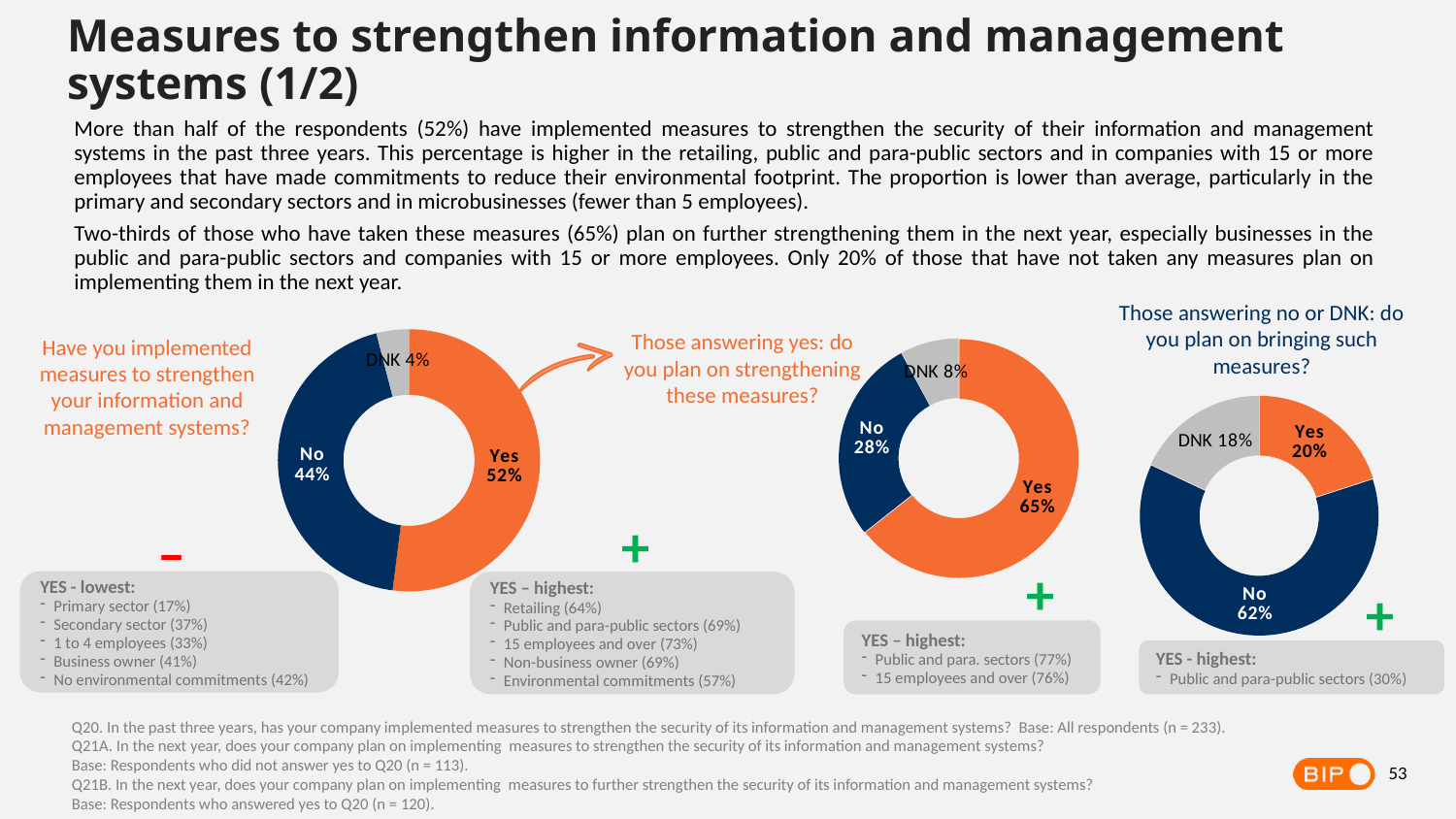
In the left chart ('Have you implemented measures to strengthen your information and management systems?'), what percentage answered Yes? 52% In the right chart ('Those answering no or DNK...'), which is larger, Yes or DNK? Yes In the left chart ('Have you implemented measures...'), which response has the smallest share? DNK In the right chart ('Those answering no or DNK...'), what percentage answered DNK? 18% In the left chart ('Have you implemented measures...'), what percentage answered No? 44% In the middle chart ('Those answering yes...'), which response has the largest share? Yes In the left chart ('Have you implemented measures...'), what is the difference in percentage points between Yes and No? 8 What kind of chart is used for the three charts on the slide? Donut (pie) chart In the middle chart ('Those answering yes: do you plan on strengthening these measures?'), what percentage answered Yes? 65% In the right chart ('Those answering no or DNK: do you plan on bringing such measures?'), what percentage answered No? 62% In the middle chart ('Those answering yes...'), what percentage answered DNK? 8% How many charts are shown on the slide? 3